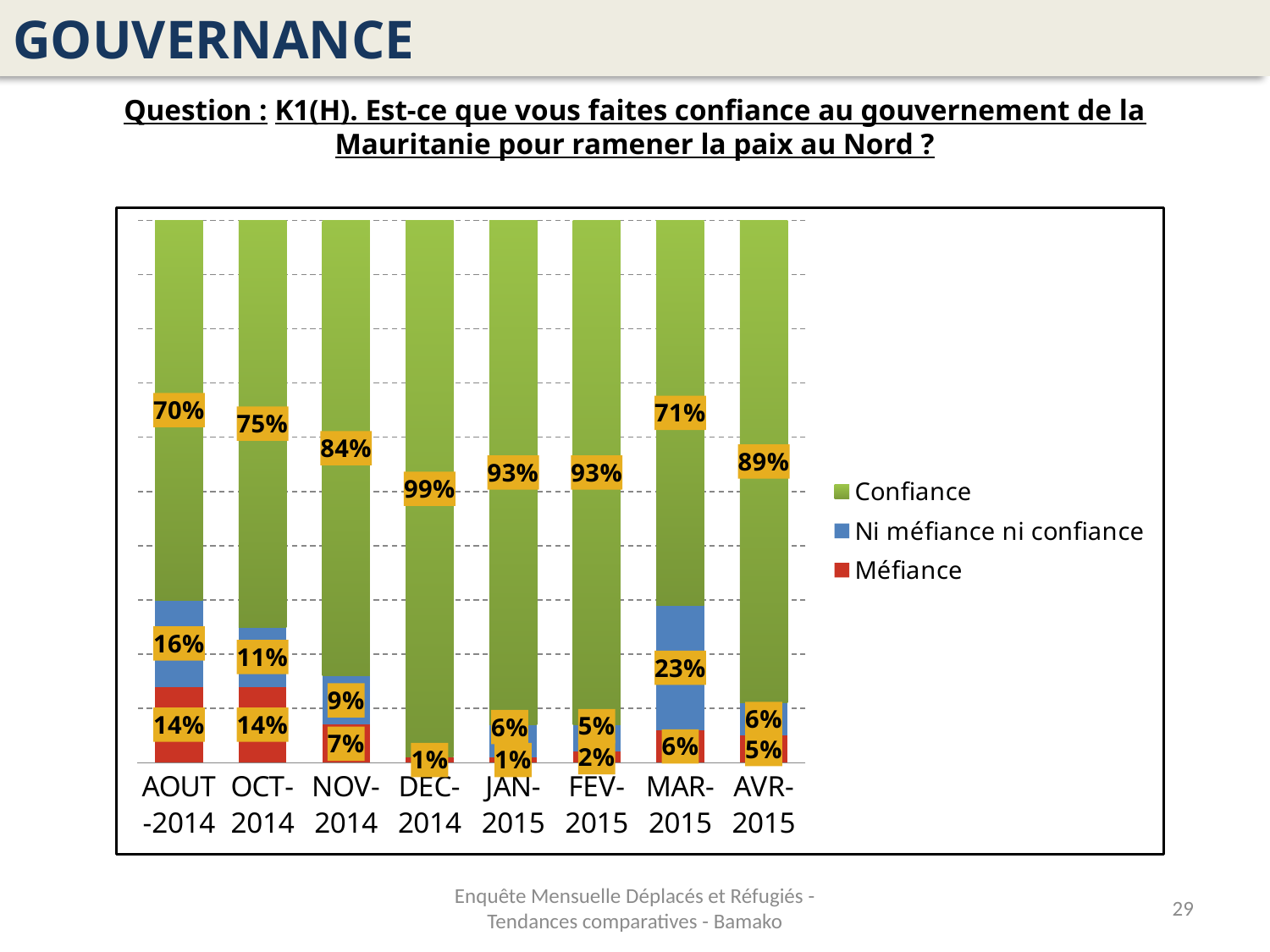
How many time periods (categories) are shown on the x axis? 8 What is the total of the three segments of the AOUT-2014 bar? 100% What kind of chart is shown on the slide? stacked bar chart What is the Confiance value for AOUT-2014? 70% What is the difference between the Confiance values for AVR-2015 and MAR-2015? 18% How many series does the legend list? 3 In which period is the Confiance value highest? DEC-2014 What is the Ni méfiance ni confiance value for MAR-2015? 23% What is the Méfiance value for OCT-2014? 14% Which series is shown in red in the legend? Méfiance Which is larger, the Confiance value for NOV-2014 or for OCT-2014? NOV-2014 In which period is the Confiance value lowest? AOUT-2014